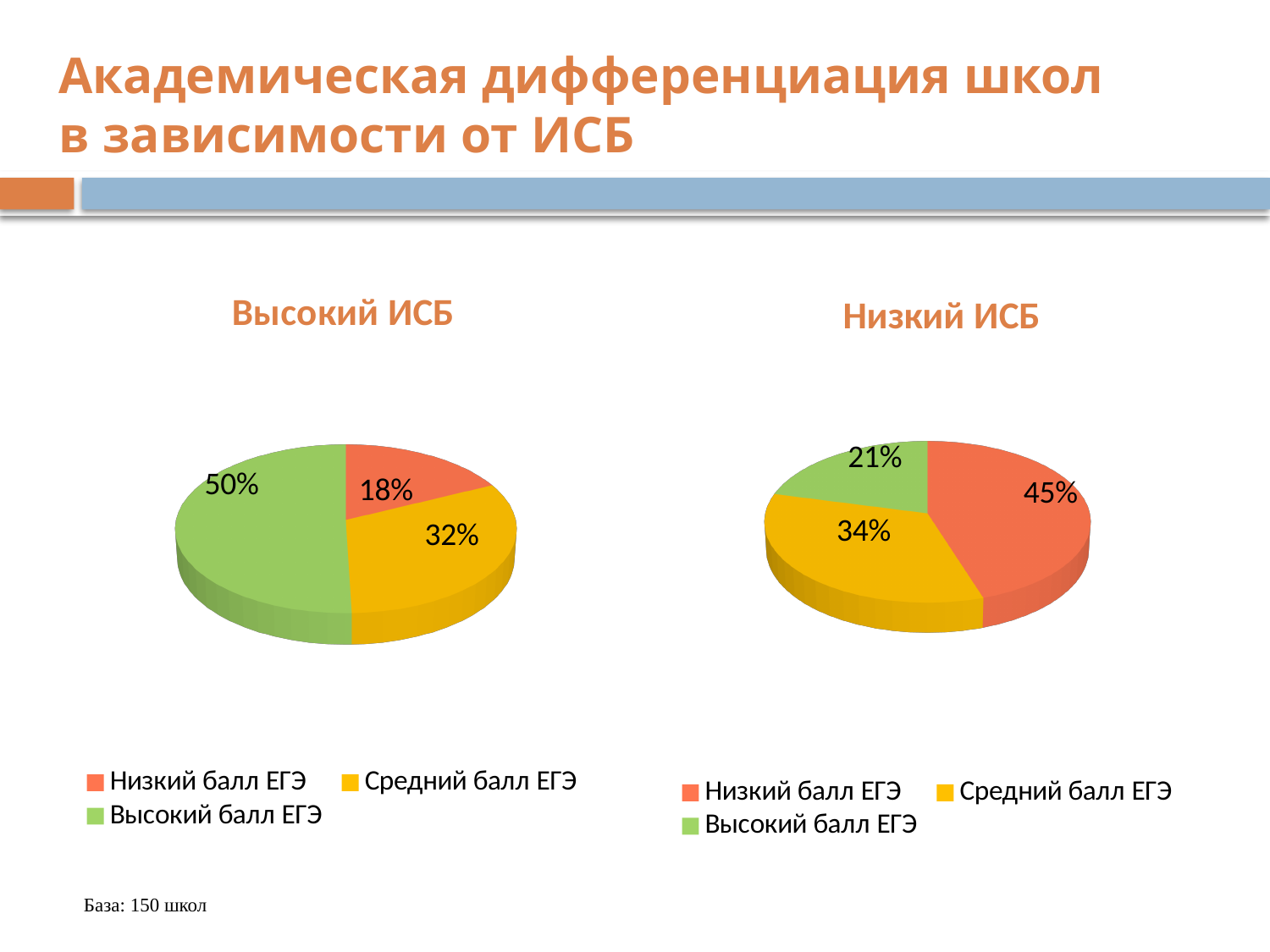
In the "Низкий ИСБ" chart, which category has the largest slice? Низкий балл ЕГЭ How many categories does the legend of the "Низкий ИСБ" chart list? 3 In the "Низкий ИСБ" chart, what share is labelled for Низкий балл ЕГЭ? 45% In the "Высокий ИСБ" chart, which category has the largest slice? Высокий балл ЕГЭ In the "Высокий ИСБ" chart, what is the difference between the Средний балл ЕГЭ and Низкий балл ЕГЭ shares? 14% In the "Высокий ИСБ" chart, what share is labelled for Высокий балл ЕГЭ? 50% What type of chart is used for "Высокий ИСБ"? Pie chart In the "Низкий ИСБ" chart, which category has the smallest slice? Высокий балл ЕГЭ In the "Высокий ИСБ" chart, what share is labelled for Низкий балл ЕГЭ? 18% What is the difference between the Высокий балл ЕГЭ share in the "Высокий ИСБ" chart and in the "Низкий ИСБ" chart? 29% In the "Низкий ИСБ" chart, what share is labelled for Средний балл ЕГЭ? 34% Which is larger: the Низкий балл ЕГЭ share in the "Низкий ИСБ" chart or in the "Высокий ИСБ" chart? Низкий ИСБ